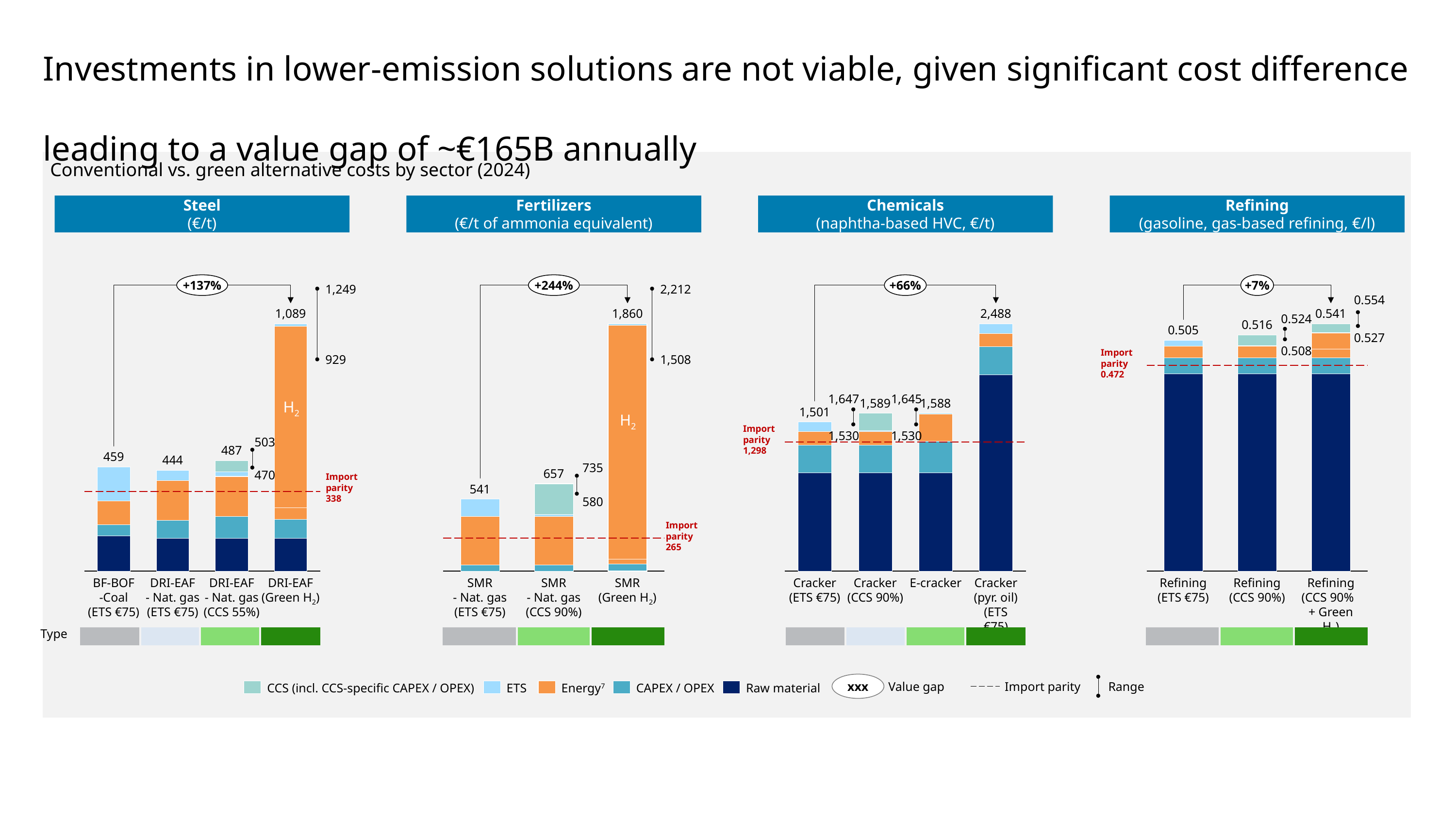
In the Fertilizers chart, what is the import parity value? 265 In the Chemicals chart, what is the value gap percentage shown in the oval? +66% In the Refining chart, which is larger: the total for Refining (CCS 90%) or Refining (ETS €75)? Refining (CCS 90%) In the Steel chart, what is the total cost for BF-BOF-Coal (ETS €75)? 459 What type of chart is used in the Steel panel? Stacked bar chart In the Steel chart, what is the total cost for DRI-EAF (Green H2)? 1,089 In the Steel chart, which option has the lowest total cost? DRI-EAF - Nat. gas (ETS €75) How many cost components does the legend list for the stacked bars? 5 In the Fertilizers chart, what is the total cost for SMR - Nat. gas (CCS 90%)? 657 In the Fertilizers chart, what is the difference between the total cost of SMR (Green H2) and SMR - Nat. gas (ETS €75)? 1,319 How many bars are shown in the Refining chart? 3 In the Chemicals chart, which option has the highest total cost? Cracker (pyr. oil) (ETS €75)